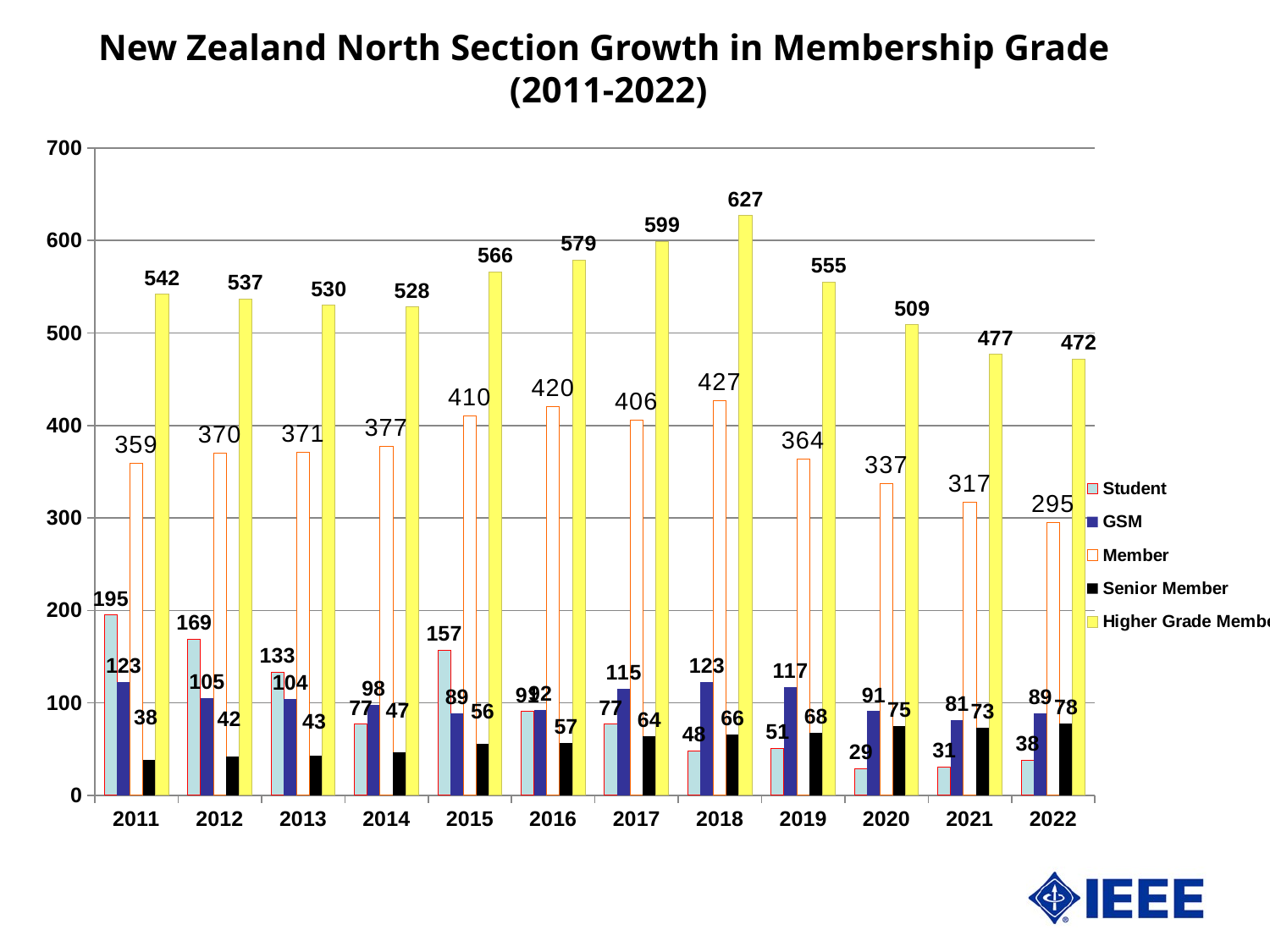
What kind of chart is shown on the slide? bar chart How many series does the legend list? 5 What is the difference between the Higher Grade Member value in 2018 and in 2022? 155 How many years are shown on the x axis? 12 In 2011, which is larger: the Student value or the GSM value? Student In which year is the Member value lowest? 2022 What is the Student value for 2020? 29 What is the difference between the Member value in 2018 and in 2011? 68 Do the Senior Member values generally rise or fall from 2011 to 2022? rise In which year is the Higher Grade Member value highest? 2018 What is the Senior Member value for 2011? 38 What is the Higher Grade Member value for 2018? 627